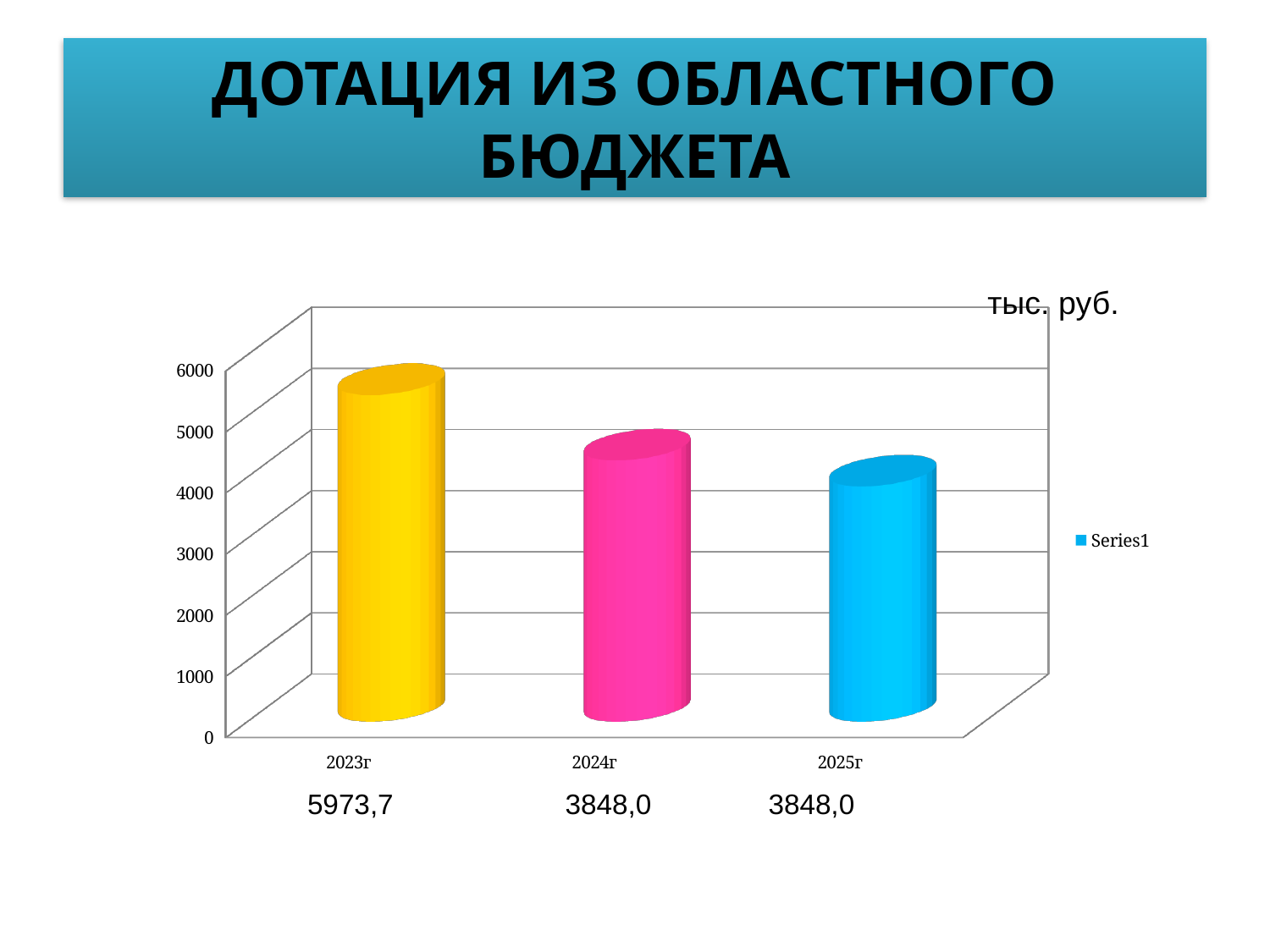
Which is larger, the value for 2023г or the value for 2025г? 2023г Is the value for 2024г greater or less than 5000? less What is the value for 2024г? 3848,0 Which year has the highest value? 2023г How many series does the legend list? 1 What kind of chart is shown on the slide? bar chart What is the value for 2025г? 3848,0 Is the value for 2023г greater or less than 5000? greater What is the difference between the values for 2023г and 2024г? 2125,7 Do the values rise or fall from 2023г to 2025г? fall What is the value for 2023г? 5973,7 How many years are shown on the chart? 3